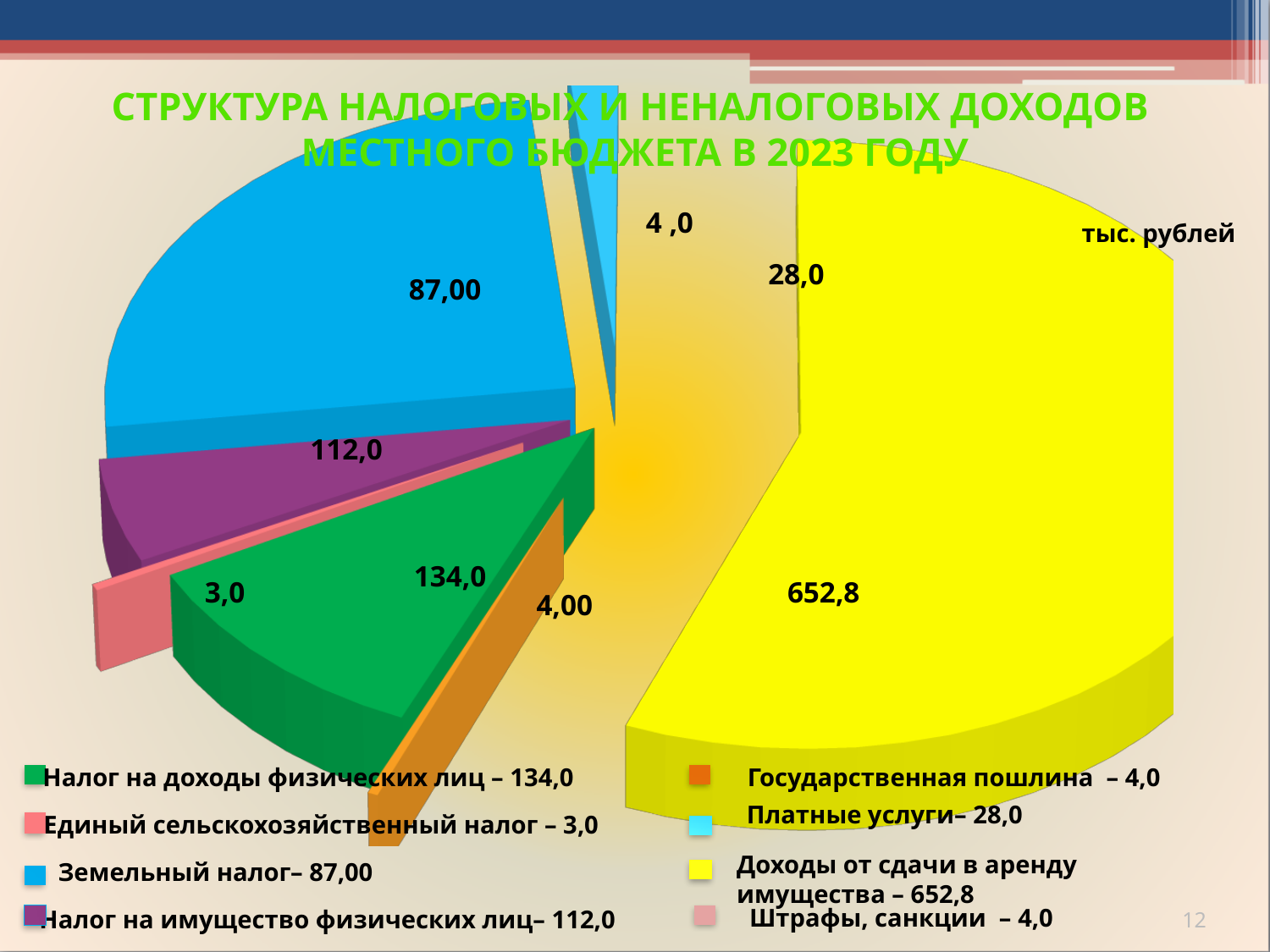
What is the value for Доходы от сдачи в аренду имущества? 652,8 Which category has the largest slice of the pie? Доходы от сдачи в аренду имущества What unit of measurement is indicated on the slide for the chart values? тыс. рублей What is the value for Земельный налог? 87,00 How many categories does the pie chart have? 8 Which category has the smallest value? Единый сельскохозяйственный налог What is the value for Налог на доходы физических лиц? 134,0 Which is larger, Земельный налог or Налог на имущество физических лиц? Налог на имущество физических лиц What kind of chart is shown on the slide? Pie chart What is the difference between Доходы от сдачи в аренду имущества and Налог на доходы физических лиц? 518,8 What is the value for Платные услуги? 28,0 What is the difference between Налог на доходы физических лиц and Налог на имущество физических лиц? 22,0